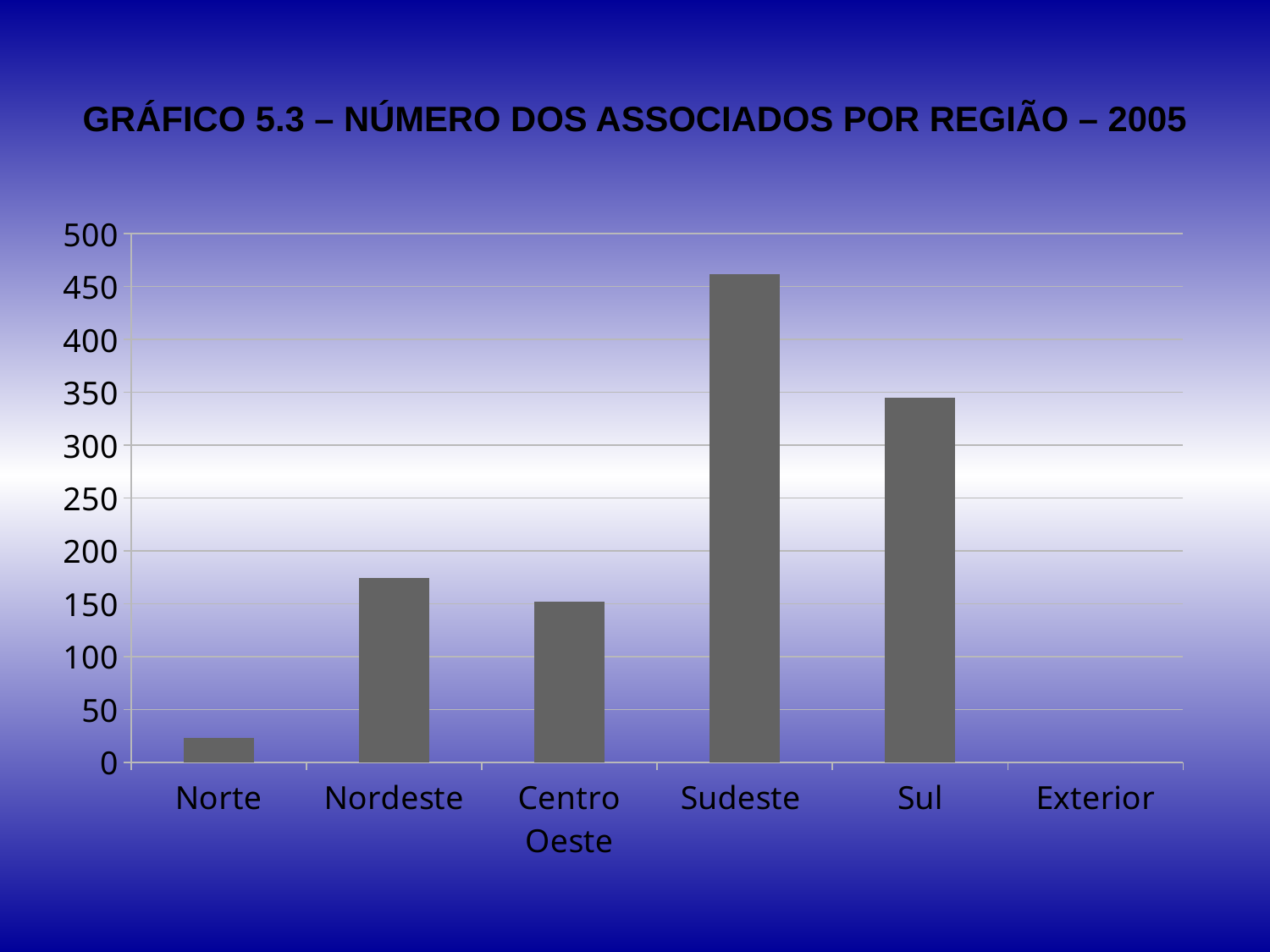
Is the value for Centro Oeste greater or less than 200? less Is the value for Norte greater or less than 50? less Which region has more associates, Sul or Sudeste? Sudeste Is the value for Sudeste greater or less than 400? greater What kind of chart is shown on the slide? bar chart Which region has the lowest number of associates? Exterior Which region has more associates, Nordeste or Centro Oeste? Nordeste Which region has the highest number of associates? Sudeste How many regions are shown on the x axis of the chart? 6 What is the title of the chart on the slide? GRÁFICO 5.3 – NÚMERO DOS ASSOCIADOS POR REGIÃO – 2005